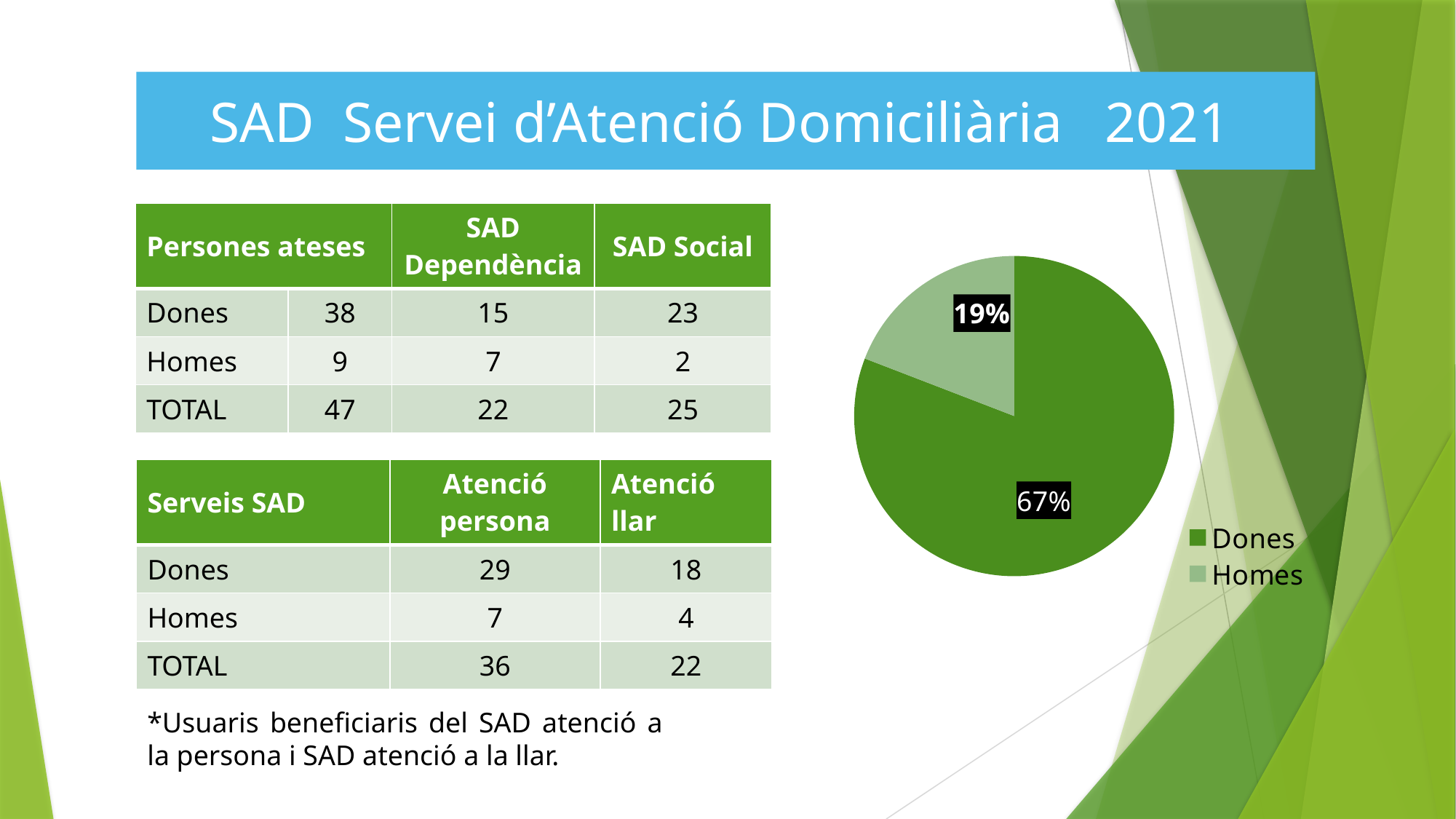
How many entries does the pie chart's legend list? 2 What percentage is shown for Homes in the pie chart? 19% What are the two legend entries of the pie chart? Dones and Homes Which legend entry is shown in the darker green colour in the pie chart? Dones In the pie chart, which slice is larger, Dones or Homes? Dones What kind of chart is shown on the slide? pie chart What percentage label is shown on the Dones slice of the pie chart? 67% How many slices does the pie chart have? 2 Which category has the smallest slice in the pie chart? Homes Which category has the largest slice in the pie chart? Dones